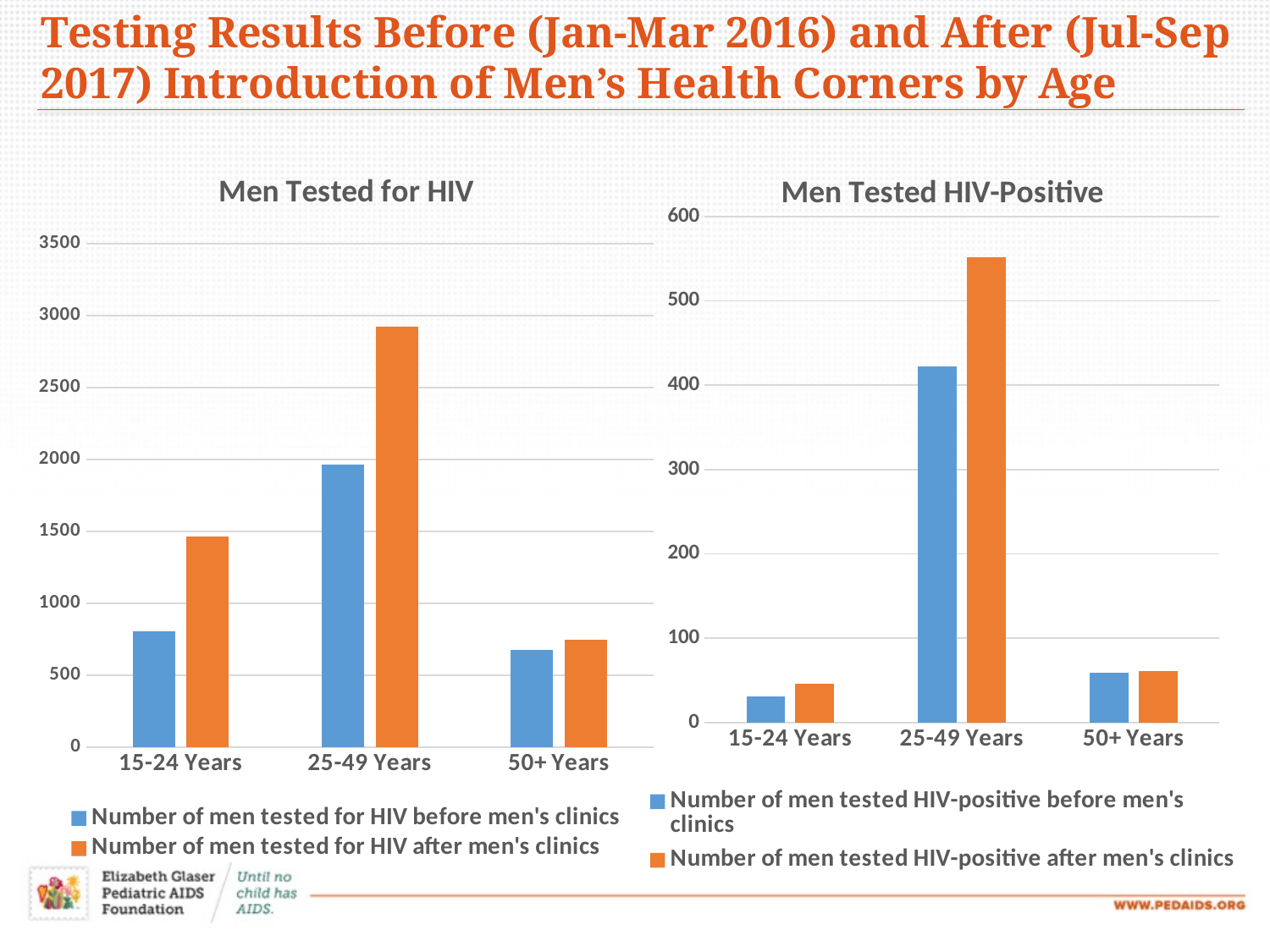
In the 'Men Tested HIV-Positive' chart, is the number of men tested HIV-positive before men's clinics for 25-49 Years greater or less than 400? greater What kind of chart is the 'Men Tested for HIV' chart? bar chart In the 'Men Tested for HIV' chart, which age group has the highest number of men tested for HIV after men's clinics? 25-49 Years In the 'Men Tested for HIV' chart, for 15-24 Years, which is larger: the number tested before men's clinics or after men's clinics? after men's clinics How many series does the legend of the 'Men Tested for HIV' chart list? 2 In the 'Men Tested HIV-Positive' chart, which age group has the lowest number of men tested HIV-positive before men's clinics? 15-24 Years In the 'Men Tested HIV-Positive' chart, is the number of men tested HIV-positive after men's clinics for 25-49 Years greater or less than 500? greater In the 'Men Tested for HIV' chart, is the number of men tested for HIV after men's clinics for 25-49 Years greater or less than 2500? greater In the 'Men Tested HIV-Positive' chart, which series do the orange bars represent? Number of men tested HIV-positive after men's clinics How many age categories are shown on the x axis of the 'Men Tested for HIV' chart? 3 In the 'Men Tested HIV-Positive' chart, which age group has the highest number of men tested HIV-positive before men's clinics? 25-49 Years